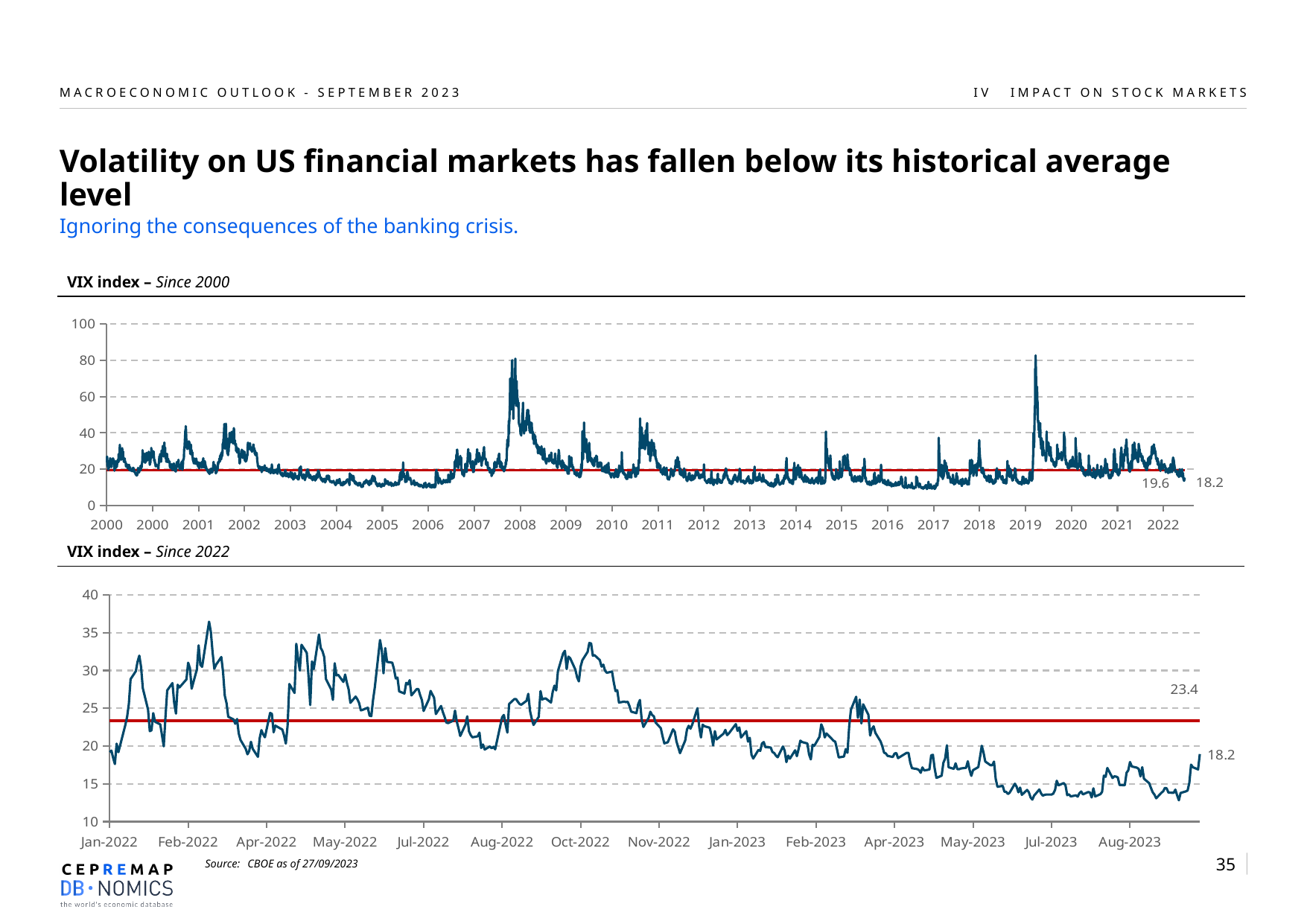
What kind of chart is the 'VIX index – Since 2000' chart? line chart In the 'VIX index – Since 2000' chart, is the highest peak of the line greater or less than 60? greater In the 'VIX index – Since 2022' chart, is the lowest point of the line greater or less than 15? less In the 'VIX index – Since 2022' chart, does the line generally rise or fall between Oct-2022 and Jul-2023? fall In the 'VIX index – Since 2000' chart, what is the latest value labelled at the end of the line? 18.2 In the 'VIX index – Since 2022' chart, which is larger: the average line value or the latest value? the average line value (23.4) In the 'VIX index – Since 2022' chart, what value is labelled on the red horizontal average line? 23.4 In the 'VIX index – Since 2022' chart, what is the difference between the average line value (23.4) and the latest value (18.2)? 5.2 In the 'VIX index – Since 2000' chart, what value is labelled on the red horizontal average line? 19.6 In the 'VIX index – Since 2000' chart, what is the difference between the average line value (19.6) and the latest value (18.2)? 1.4 What is the highest value shown on the y axis of the 'VIX index – Since 2000' chart? 100 What source is cited below the charts? CBOE as of 27/09/2023